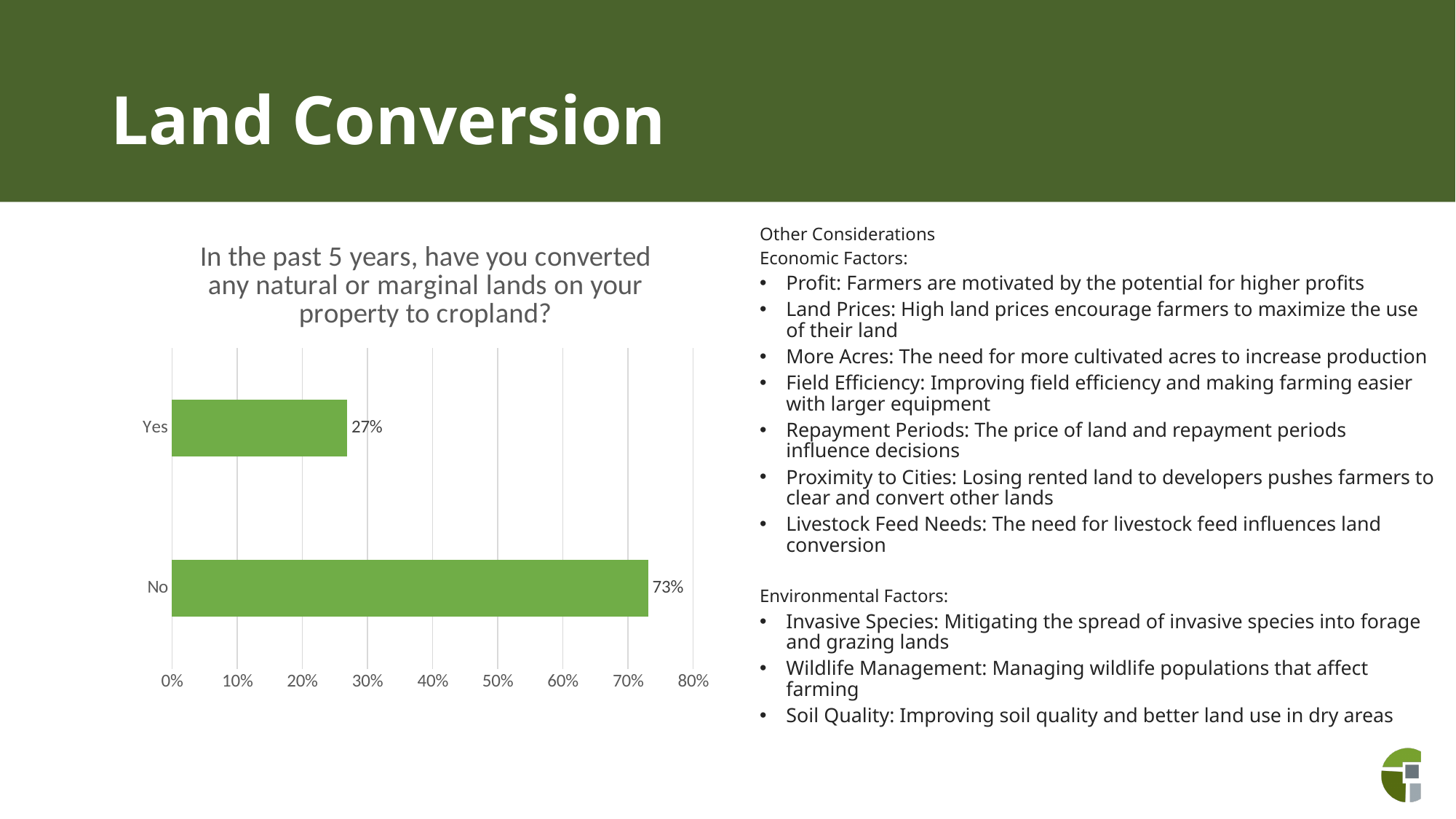
What type of chart is used to display the survey responses? Bar chart Which response category has the lowest value in the chart? Yes Is the value for "Yes" greater or less than 30%? less What is the maximum value shown on the chart's horizontal axis? 80% What is the title of the chart? In the past 5 years, have you converted any natural or marginal lands on your property to cropland? Is the value for "No" greater or less than 70%? greater What is the difference in percentage points between the "No" and "Yes" responses? 46 Which response category has the highest value in the chart? No What percentage of respondents answered "No" to having converted natural or marginal lands to cropland in the past 5 years? 73% How many response categories are shown in the chart? 2 What percentage of respondents answered "Yes" to having converted natural or marginal lands to cropland in the past 5 years? 27% Which is larger, the value for "Yes" or the value for "No"? No